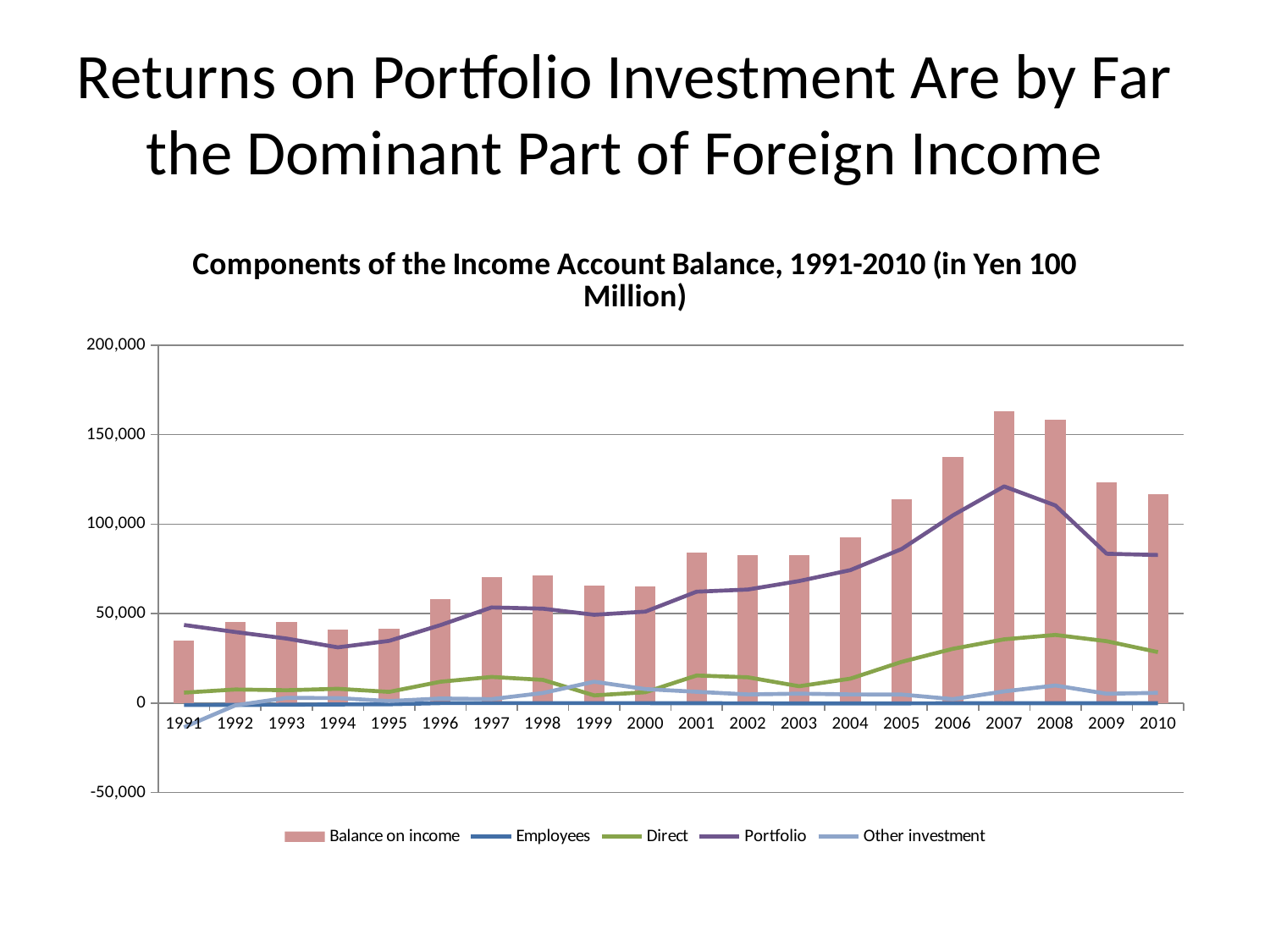
Is the Balance on income value for 1991 greater or less than 50,000? less Is the Portfolio value for 2007 greater or less than 100,000? greater Which series is plotted as bars rather than lines? Balance on income In which year is the Balance on income bar the lowest? 1991 In 2010, which is larger, the Portfolio value or the Direct value? Portfolio In which year is the Balance on income bar the highest? 2007 Is the Balance on income value for 2007 greater or less than 150,000? greater What is the title of the chart? Components of the Income Account Balance, 1991-2010 (in Yen 100 Million) How many years are shown on the x axis of the chart? 20 Does the Balance on income generally rise or fall from 1991 to 2007? rise How many series does the chart's legend list? 5